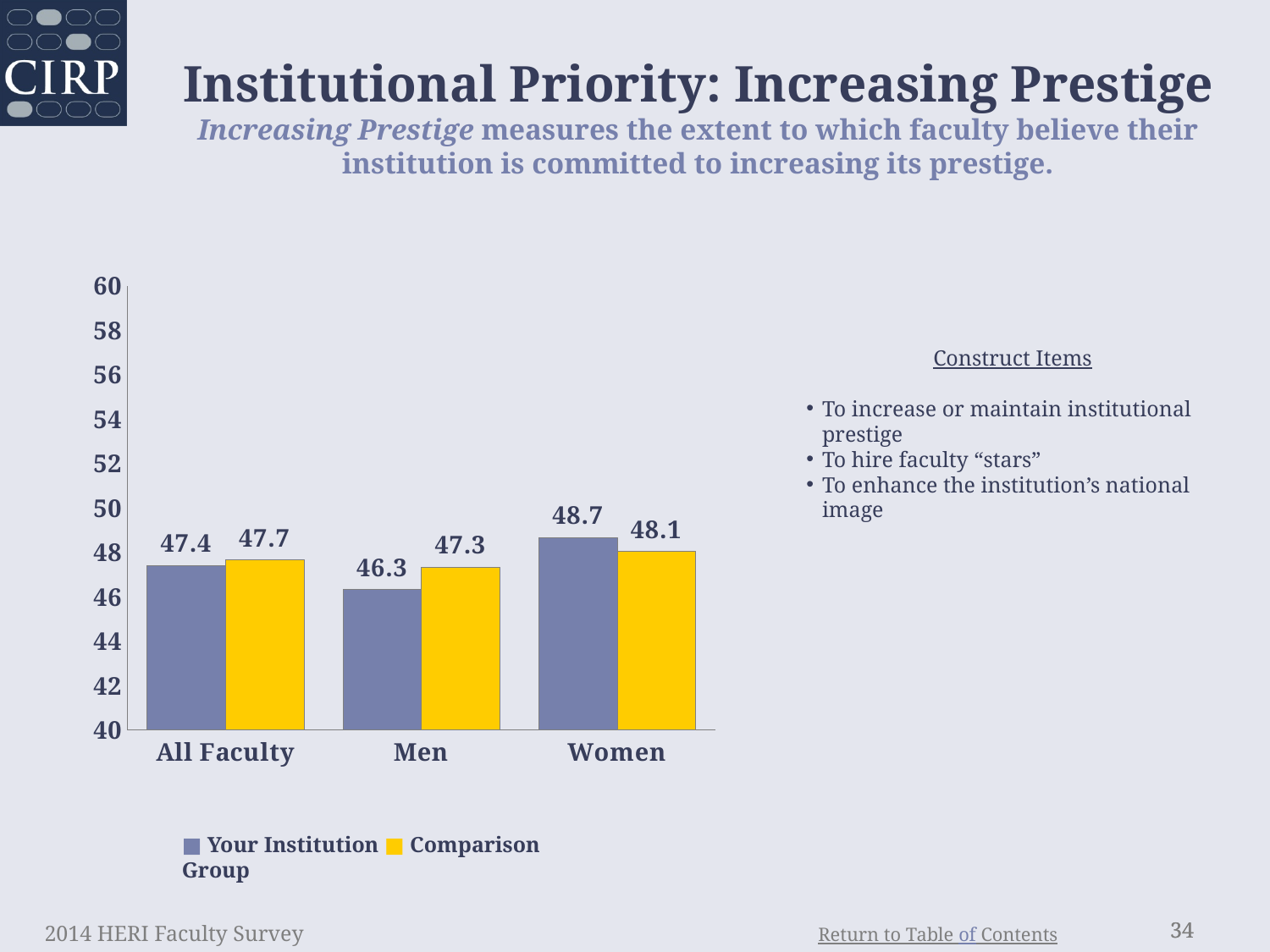
What colour are the bars for the Comparison Group? yellow Which category has the highest value for Your Institution? Women What kind of chart is shown on the slide? bar chart How many series does the legend list? 2 How many categories are shown on the x axis? 3 What is the value for Your Institution in the Women category? 48.7 Which category has the lowest value for the Comparison Group? Men For Women, which is larger: Your Institution or the Comparison Group? Your Institution What is the value for Your Institution in the All Faculty category? 47.4 What is the value for the Comparison Group in the Men category? 47.3 Is the value for Your Institution in the Men category greater or less than 48? less What is the difference between the Comparison Group and Your Institution values for Men? 1.0